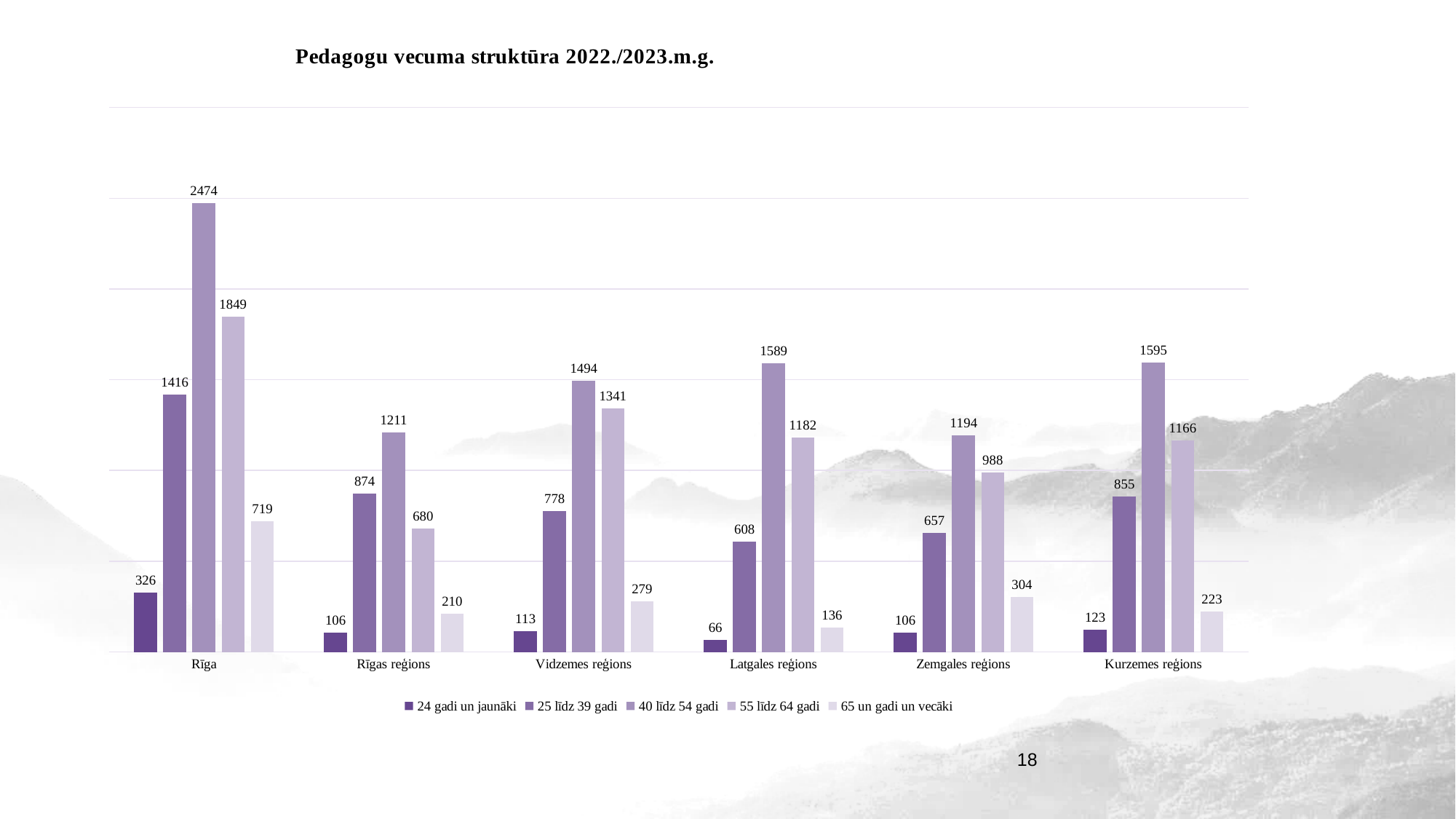
How many series does the legend list? 5 How many regions are shown on the x axis? 6 What kind of chart is shown on the slide? Bar chart What is the difference between the 55 līdz 64 gadi values in Vidzemes reģions and Latgales reģions? 159 What is the value for the 40 līdz 54 gadi series in Rīga? 2474 Which region has the lowest value for the 24 gadi un jaunāki series? Latgales reģions What is the difference between the 40 līdz 54 gadi and 55 līdz 64 gadi values in Rīga? 625 Which region has the highest value for the 40 līdz 54 gadi series? Rīga What is the title of the chart? Pedagogu vecuma struktūra 2022./2023.m.g. What is the value for the 24 gadi un jaunāki series in Latgales reģions? 66 Which is larger: the 25 līdz 39 gadi value in Vidzemes reģions or in Kurzemes reģions? Kurzemes reģions What is the value for the 65 un gadi un vecāki series in Zemgales reģions? 304